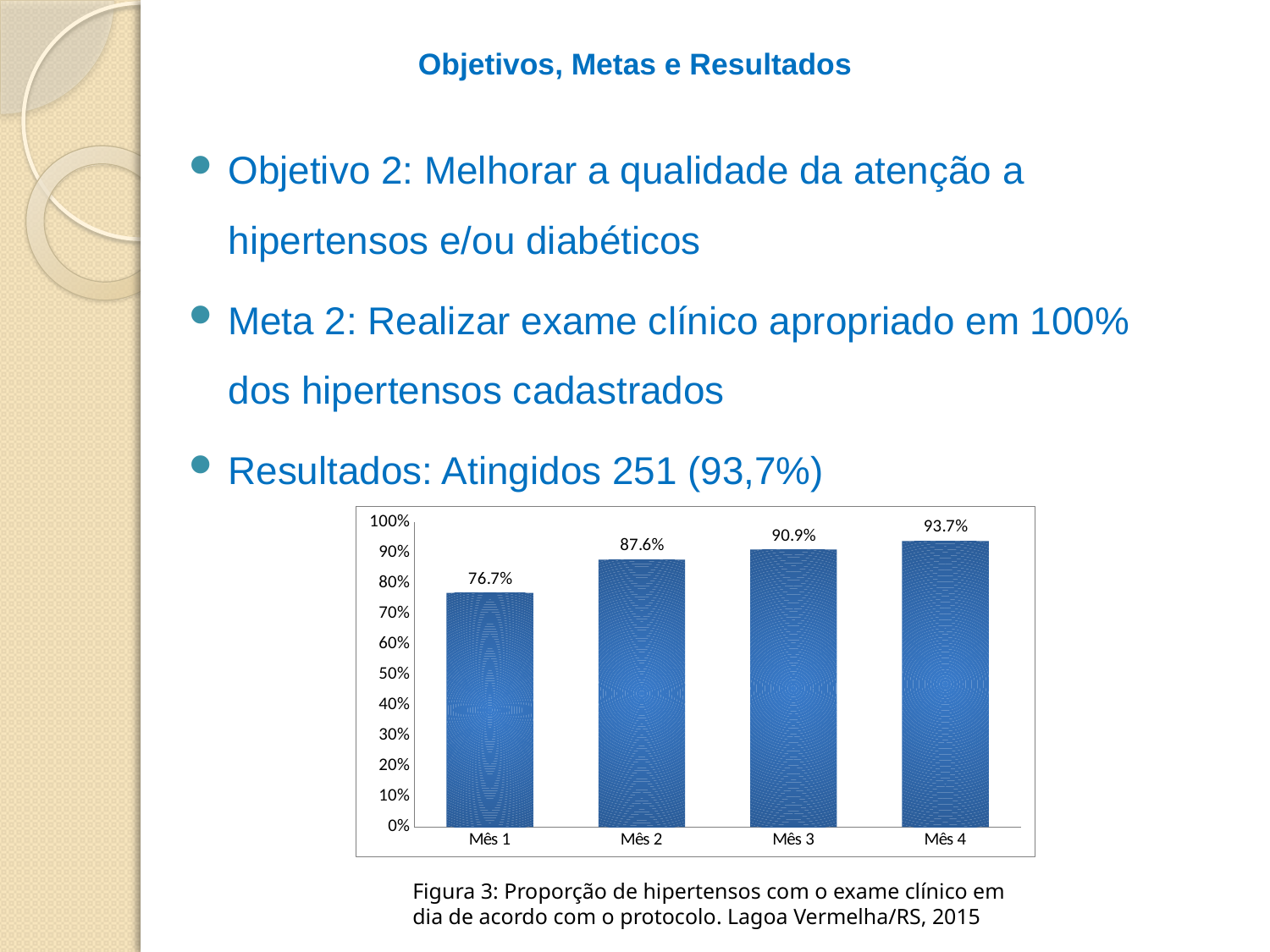
Is the value for Mês 1 greater or less than 80%? less What is the difference between the values for Mês 2 and Mês 1? 10.9% Which month has the lowest value? Mês 1 What kind of chart is shown on the slide? bar chart What is the difference between the values for Mês 4 and Mês 3? 2.8% Which month has the highest value? Mês 4 How many months are shown on the x axis? 4 Which is larger, the value for Mês 2 or the value for Mês 3? Mês 3 What is the value for Mês 1? 76.7% What is the value for Mês 3? 90.9% What is the value for Mês 4? 93.7% Do the values rise or fall from Mês 1 to Mês 4? rise